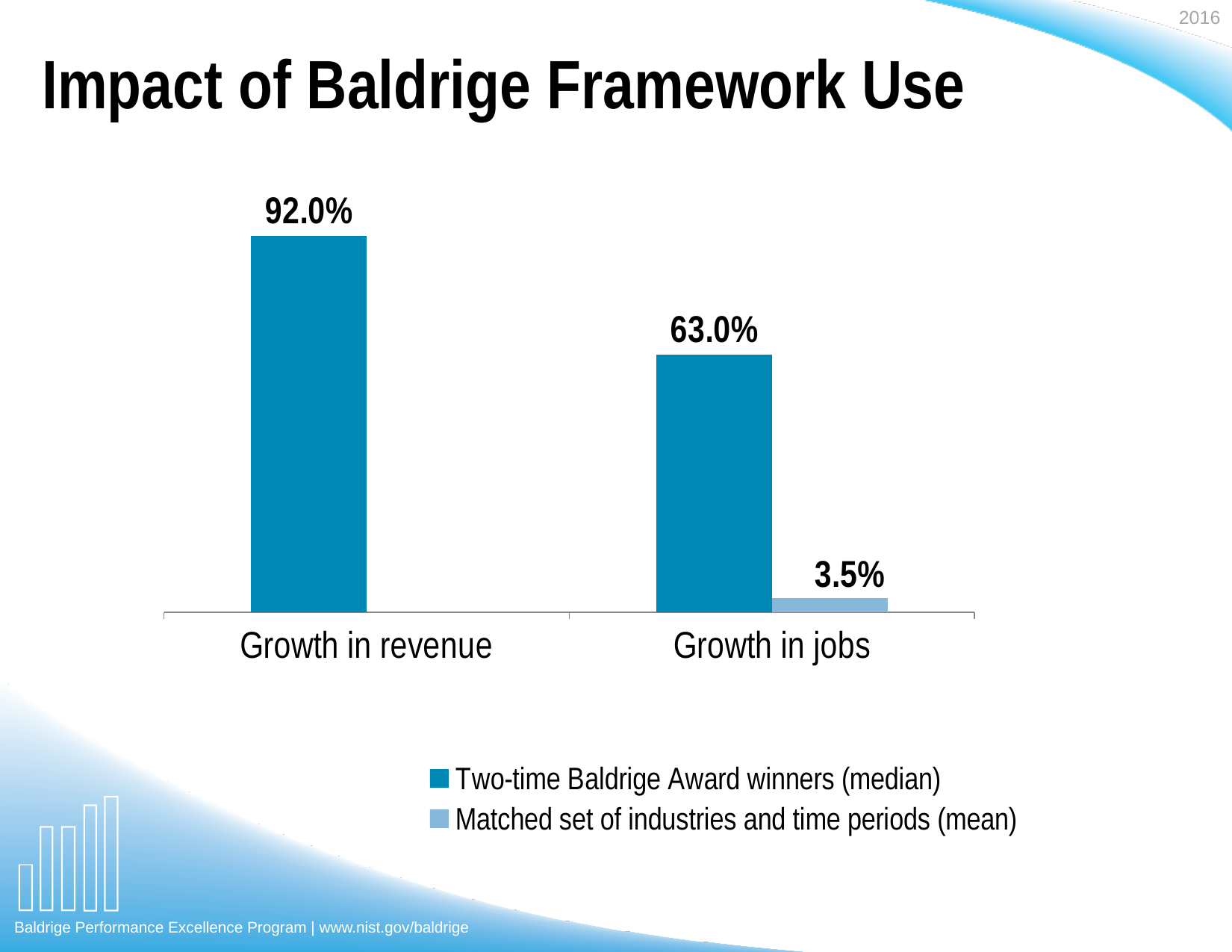
For Growth in jobs, which series has the larger value: Two-time Baldrige Award winners (median) or Matched set of industries and time periods (mean)? Two-time Baldrige Award winners (median) For Growth in jobs, what is the difference between the Two-time Baldrige Award winners (median) value and the Matched set of industries and time periods (mean) value? 59.5% How many categories are shown on the x axis of the chart? 2 Which legend entry is shown in the lighter blue colour? Matched set of industries and time periods (mean) What is the title of the slide containing the chart? Impact of Baldrige Framework Use What is the value for Two-time Baldrige Award winners (median) for Growth in jobs? 63.0% Which category has the highest value for Two-time Baldrige Award winners (median)? Growth in revenue What is the value for Two-time Baldrige Award winners (median) for Growth in revenue? 92.0% What is the difference between the Two-time Baldrige Award winners (median) values for Growth in revenue and Growth in jobs? 29.0% What is the value for Matched set of industries and time periods (mean) for Growth in jobs? 3.5% What kind of chart is shown on the slide? Bar chart How many series does the legend list? 2